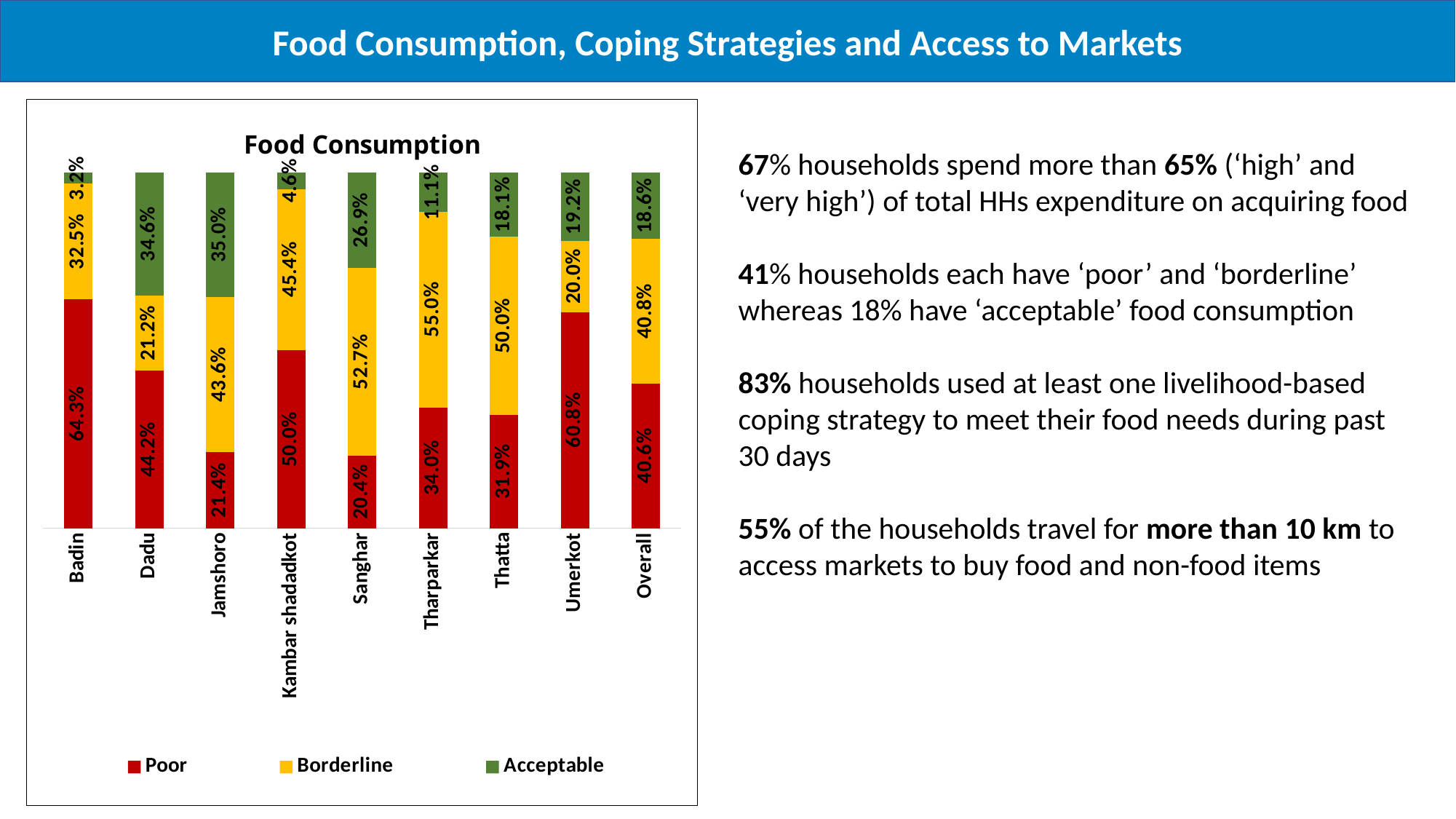
How many categories are shown on the x axis? 9 What is the Acceptable value for Dadu? 34.6% How many series does the legend list? 3 What is the Borderline value for Sanghar? 52.7% What is the Poor value for Badin? 64.3% What is the title of the chart? Food Consumption What is the Poor value for Overall? 40.6% What is the difference between the Poor values for Umerkot and Thatta? 28.9% Which is larger, the Borderline value for Tharparkar or the Borderline value for Jamshoro? Tharparkar Which category has the lowest Acceptable value? Badin Which district has the highest Poor value? Badin What kind of chart is shown? Stacked bar chart